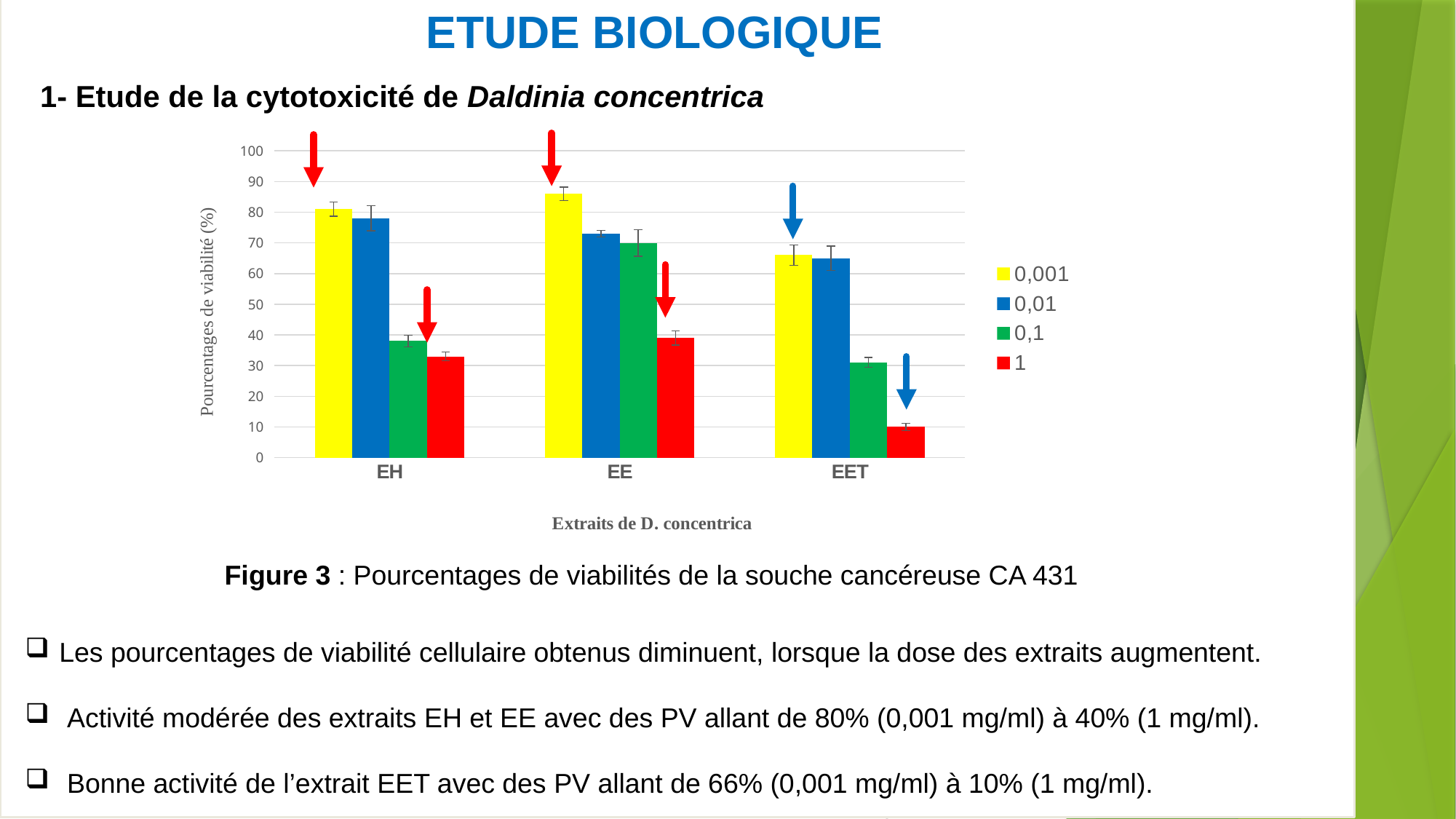
How many series does the legend list? 4 Which extract has the highest viability for the 0,001 series? EE Within each extract, do the viability values rise or fall as the series goes from 0,001 to 1? fall How many extract categories are shown on the x axis? 3 Is the value for EET in the 0,1 series greater or less than 40? less Which colour represents the 0,1 series in the legend? green What kind of chart is shown on the slide? bar chart Is the value for EE in the 0,001 series greater or less than 80? greater Which is larger for EH: the 0,001 series or the 0,1 series? 0,001 Is the value for EET in the 1 series greater or less than 20? less Which extract has the lowest viability for the 1 series? EET What is the label of the y axis? Pourcentages de viabilité (%)